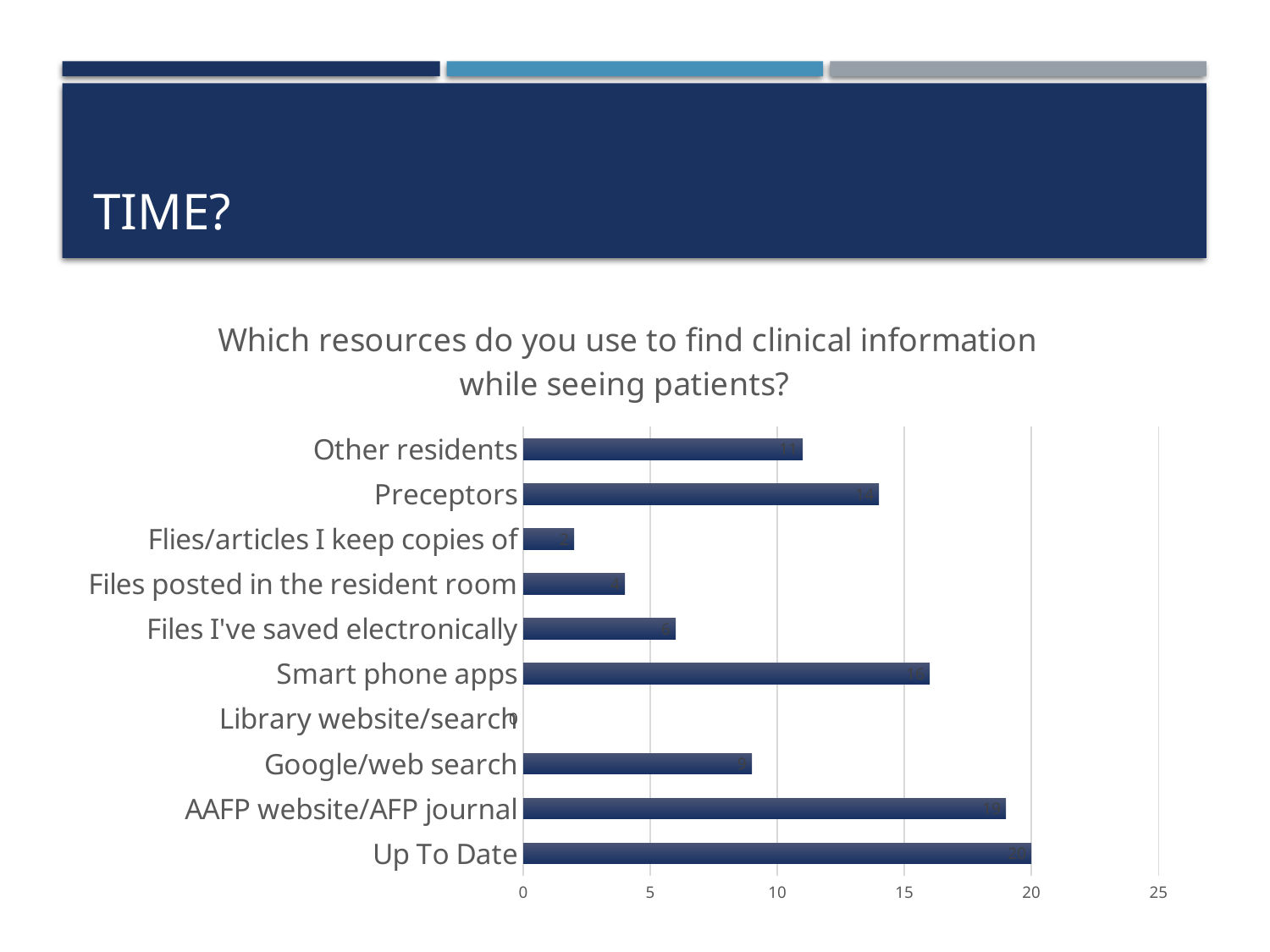
What is the value for AAFP website/AFP journal? 19 What is the title of the chart? Which resources do you use to find clinical information while seeing patients? What is the value for Smart phone apps? 16 What is the value for Up To Date? 20 What is the value for Library website/search? 0 Which resource has the highest value? Up To Date Is the value for Google/web search greater or less than 10? less How many resource categories are plotted in the chart? 10 Which resource has the lowest value? Library website/search What is the difference between the values for Up To Date and Smart phone apps? 4 Which is larger, the value for Preceptors or the value for Other residents? Preceptors What type of chart is shown on the slide? bar chart